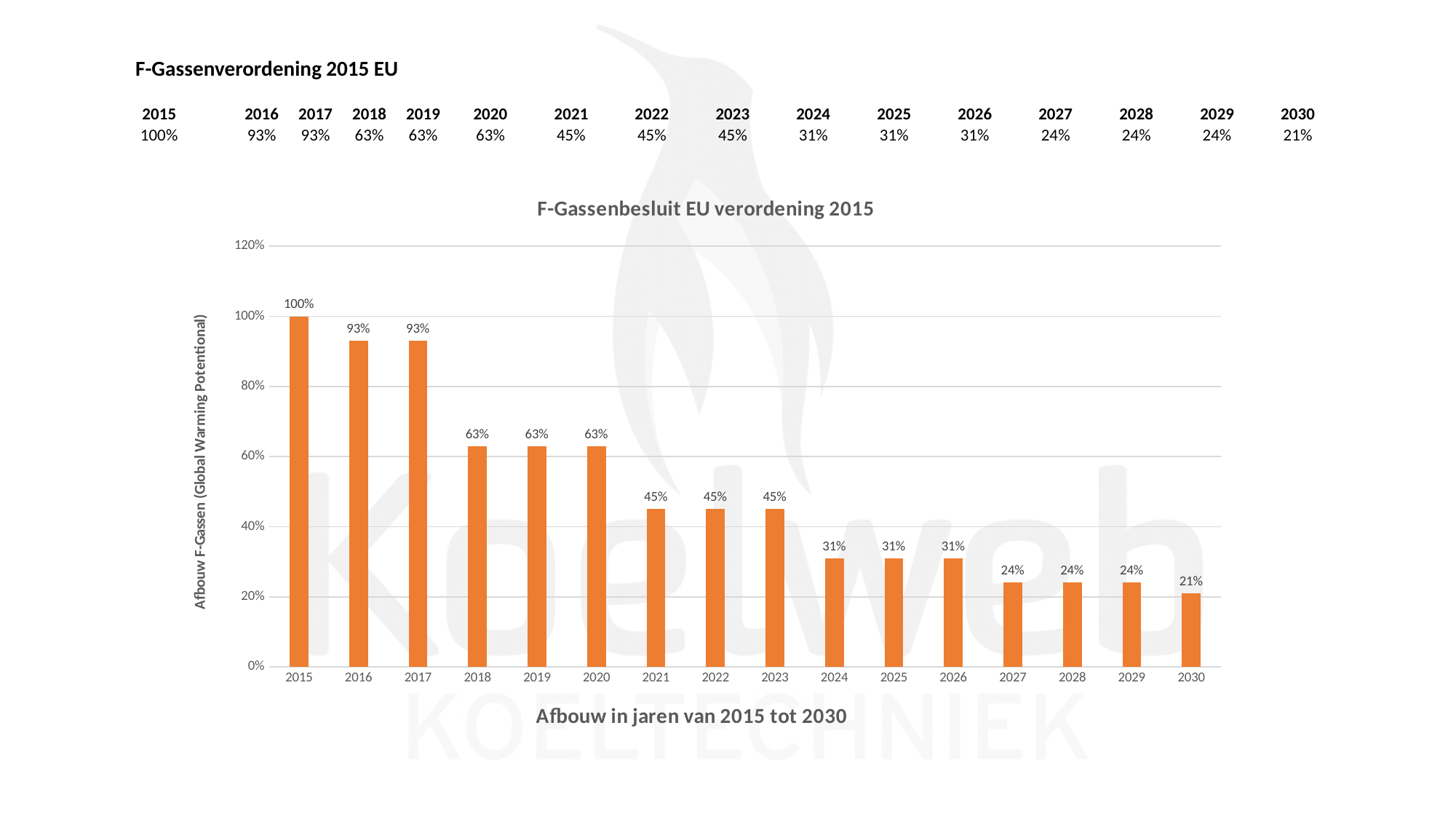
What is the difference between the values for 2015 and 2030? 79% Is the value for 2023 greater or less than 40%? greater How many years are shown on the x axis? 16 Do the values rise or fall from 2015 to 2030? fall What is the difference between the values for 2017 and 2018? 30% What is the value for 2015? 100% What is the value for 2030? 21% Which year has the lowest value? 2030 Which year has the highest value? 2015 What kind of chart is this? bar chart What is the value for 2021? 45% Which is larger, the value for 2020 or the value for 2024? 2020